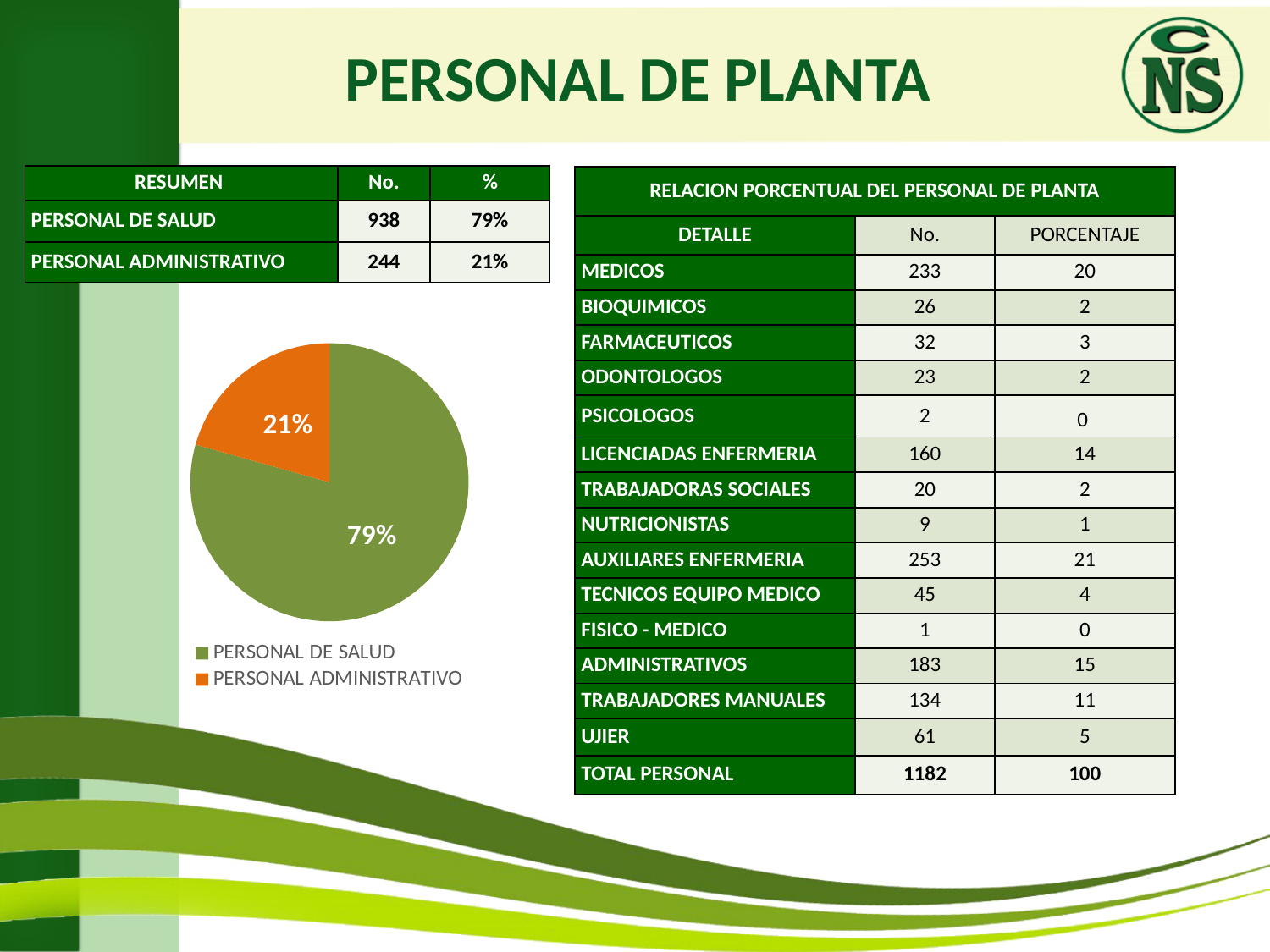
What colour is the PERSONAL ADMINISTRATIVO slice in the pie chart? Orange Which slice is larger in the pie chart, PERSONAL DE SALUD or PERSONAL ADMINISTRATIVO? PERSONAL DE SALUD What share of the pie chart does PERSONAL DE SALUD represent? 79% Which category has the largest slice in the pie chart? PERSONAL DE SALUD How many slices does the pie chart have? 2 What share of the pie chart does PERSONAL ADMINISTRATIVO represent? 21% What colour is the PERSONAL DE SALUD slice in the pie chart? Green By how many percentage points does the PERSONAL DE SALUD slice exceed the PERSONAL ADMINISTRATIVO slice? 58 percentage points What type of chart is shown on the slide? Pie chart How many entries does the pie chart's legend list? 2 Which category has the smallest slice in the pie chart? PERSONAL ADMINISTRATIVO